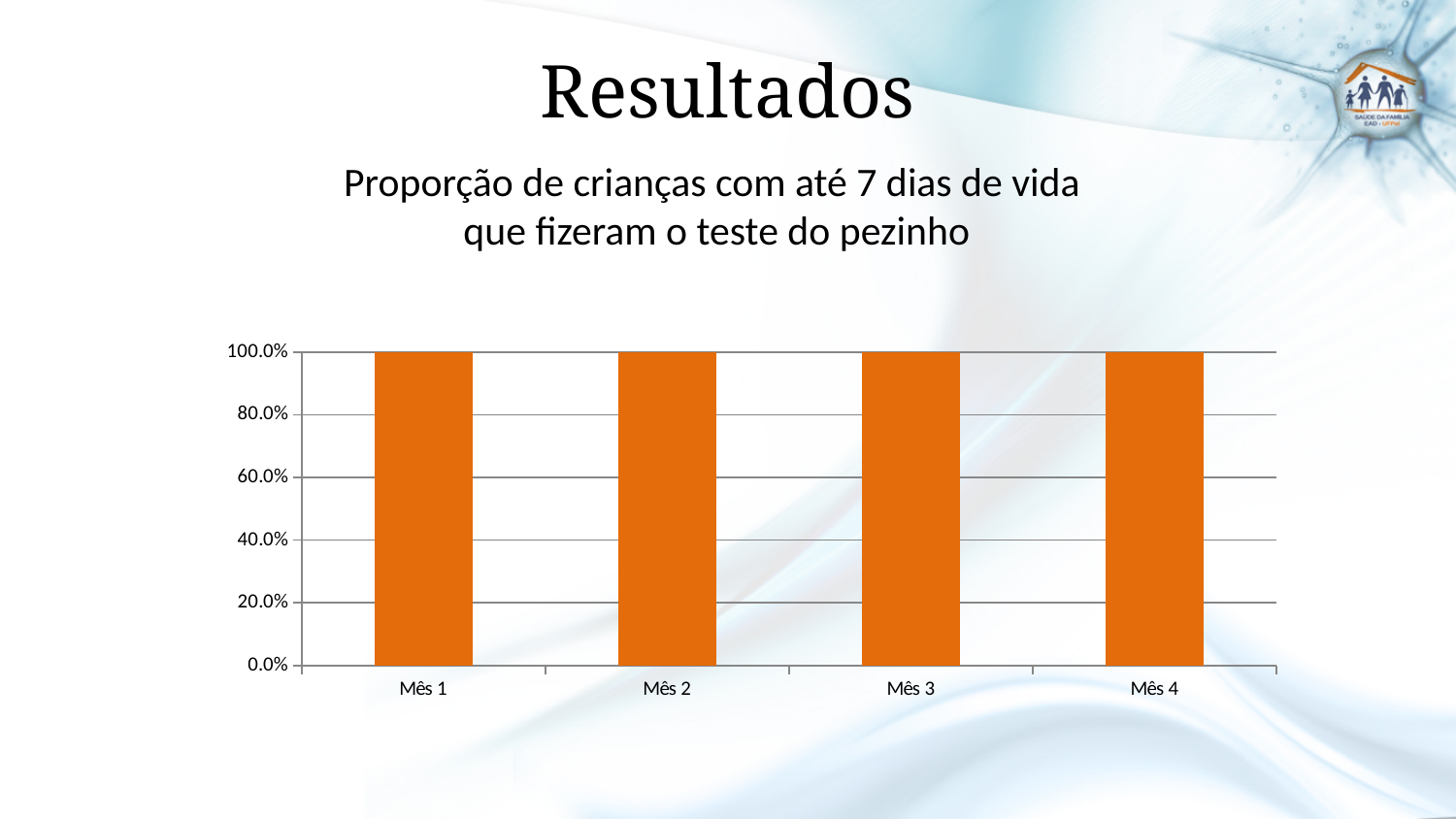
Is the value for Mês 2 greater or less than 80.0%? greater What is the difference between the values for Mês 1 and Mês 3? 0.0% What is the value for Mês 1 in the chart? 100.0% How many categories (months) are shown on the x axis of the chart? 4 What colour are the bars in the chart? orange What type of chart is shown on the slide? bar chart What is the value for Mês 3 in the chart? 100.0% Is the value for Mês 4 greater or less than 60.0%? greater What is the title of the chart on the slide? Proporção de crianças com até 7 dias de vida que fizeram o teste do pezinho Do the values rise, fall, or stay the same from Mês 1 to Mês 4? stay the same What is the value for Mês 2 in the chart? 100.0% What is the value for Mês 4 in the chart? 100.0%